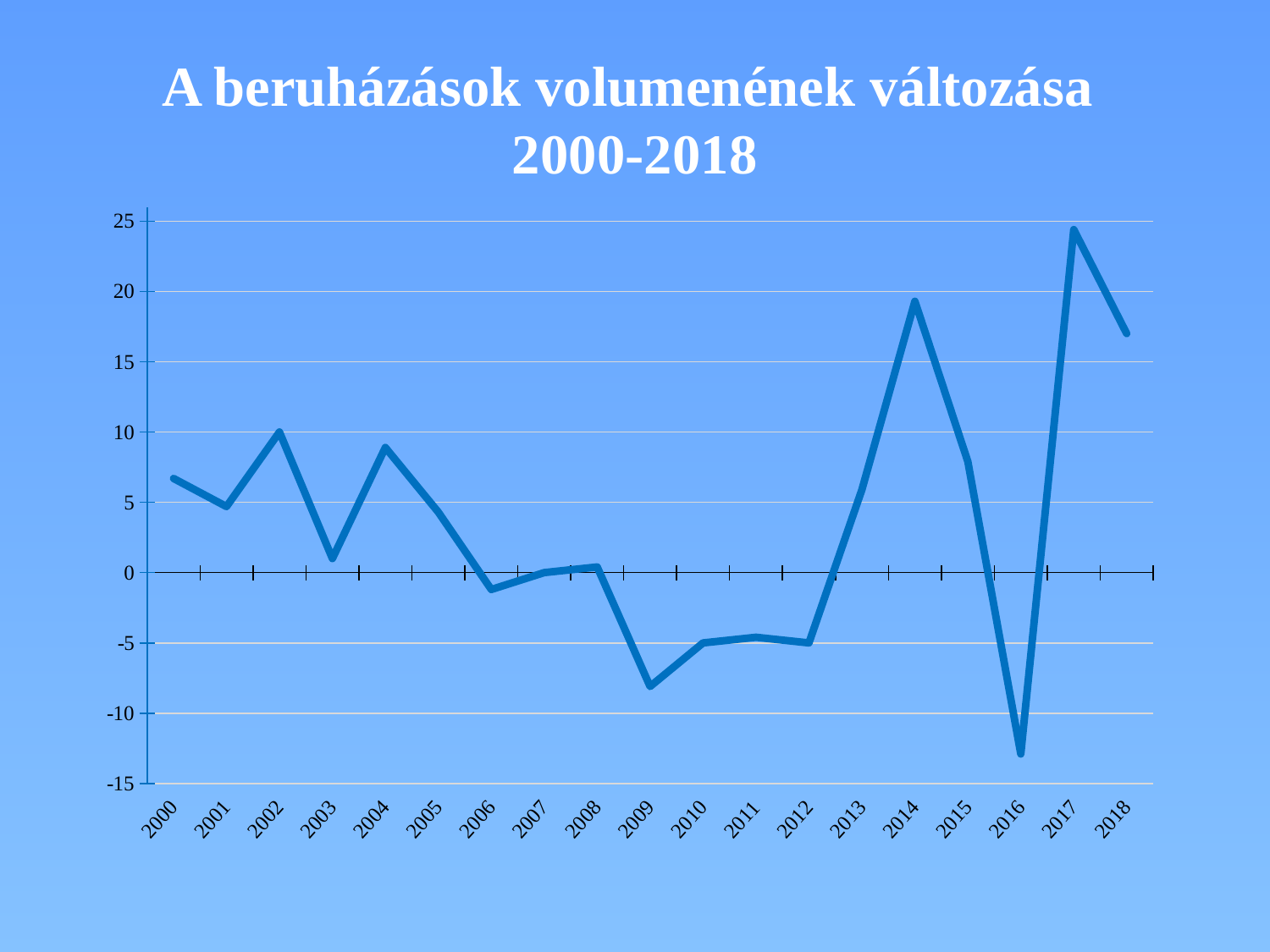
Which is larger, the value for 2000 or the value for 2001? 2000 Is the value for 2009 greater or less than -5? less Which is larger, the value for 2009 or the value for 2010? 2010 What kind of chart is shown on the slide? line chart What is the title of the chart? A beruházások volumenének változása 2000-2018 Is the value for 2016 greater or less than -10? less Is the value for 2004 greater or less than 5? greater Do the values rise or fall from 2014 to 2016? fall Which year has the highest value? 2017 Which year has the lowest value? 2016 How many years are plotted on the x axis? 19